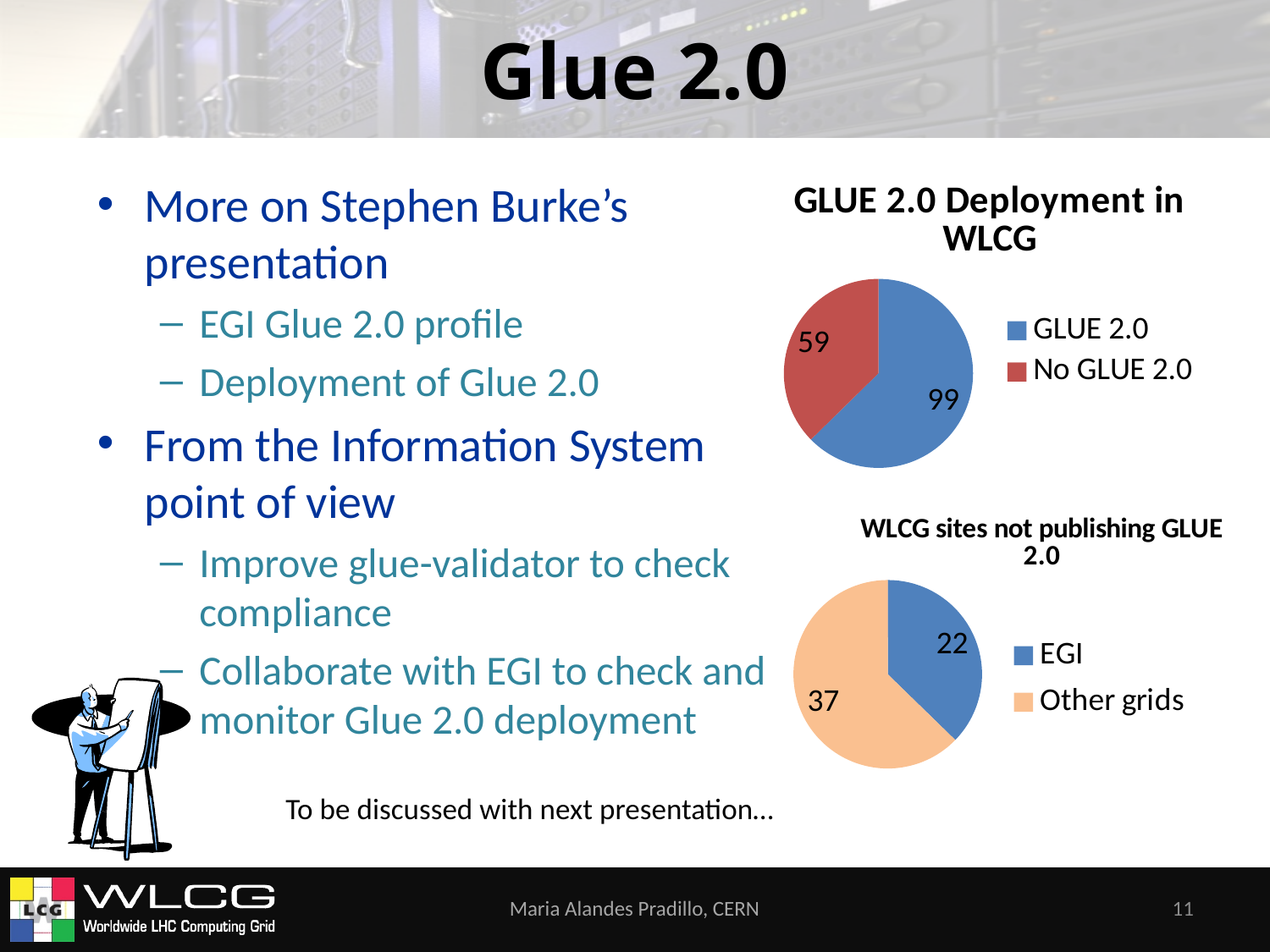
In the 'WLCG sites not publishing GLUE 2.0' chart, what is the value for EGI? 22 What type of chart is the 'GLUE 2.0 Deployment in WLCG' chart? Pie chart How many categories does the 'WLCG sites not publishing GLUE 2.0' chart's legend list? 2 In the 'WLCG sites not publishing GLUE 2.0' chart, which category has the smallest slice? EGI In the 'GLUE 2.0 Deployment in WLCG' chart, what is the total of the two slices? 158 In the 'GLUE 2.0 Deployment in WLCG' chart, which category has the largest slice? GLUE 2.0 In the 'GLUE 2.0 Deployment in WLCG' chart, what is the value for No GLUE 2.0? 59 In the 'GLUE 2.0 Deployment in WLCG' chart, what is the difference between the GLUE 2.0 and No GLUE 2.0 values? 40 In the 'GLUE 2.0 Deployment in WLCG' chart, what is the value for GLUE 2.0? 99 In the 'WLCG sites not publishing GLUE 2.0' chart, what is the value for Other grids? 37 In the 'WLCG sites not publishing GLUE 2.0' chart, which is larger, EGI or Other grids? Other grids In the 'WLCG sites not publishing GLUE 2.0' chart, what is the difference between Other grids and EGI? 15